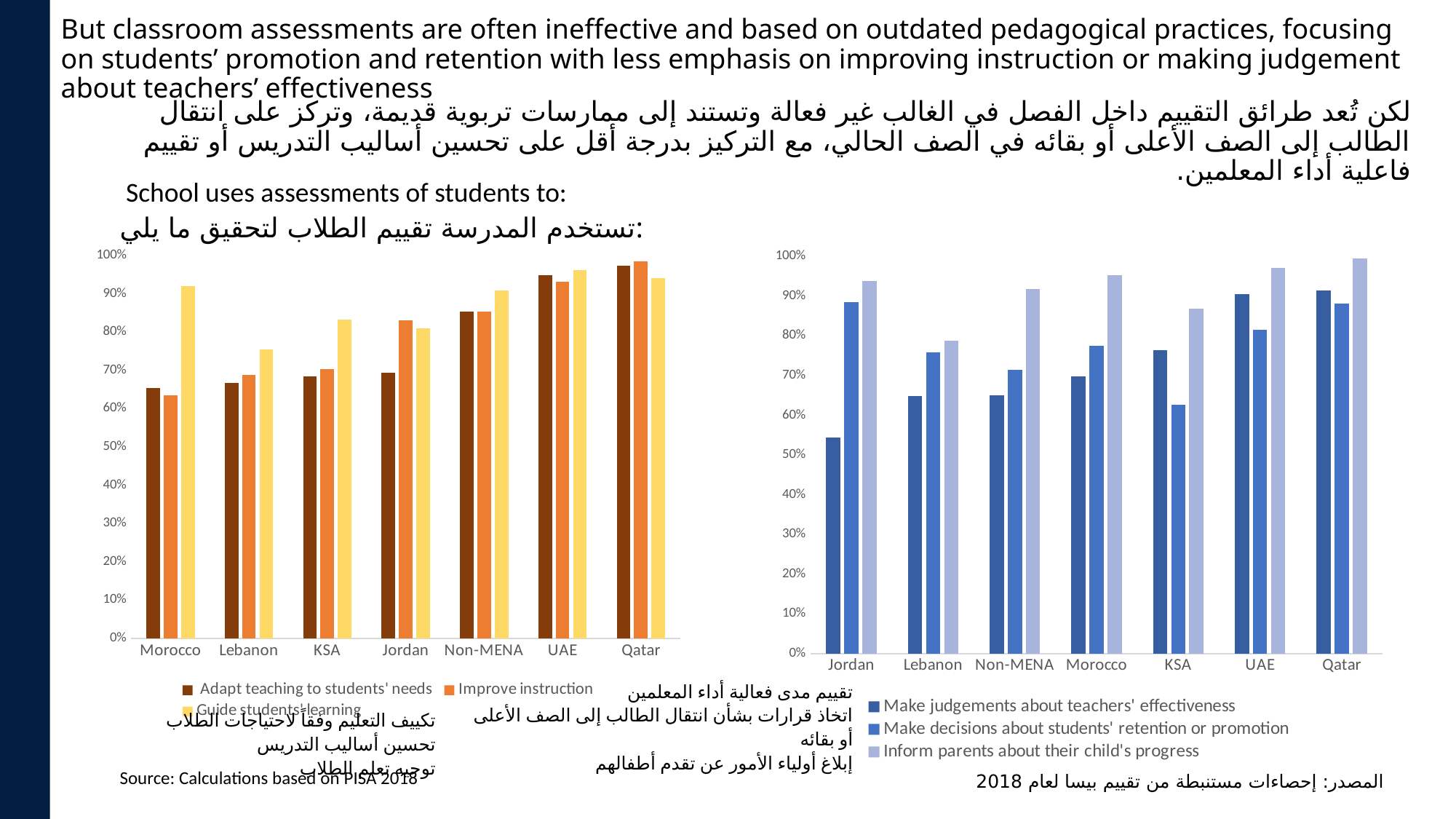
In the left chart, which category has the lowest value for 'Improve instruction'? Morocco In the right chart, for Morocco, which is larger: 'Make judgements about teachers' effectiveness' or 'Make decisions about students' retention or promotion'? Make decisions about students' retention or promotion In the left chart, which category has the lowest value for 'Guide students' learning'? Lebanon In the right chart, is the value for Lebanon for 'Inform parents about their child's progress' greater or less than 80%? less In the left chart, is the value for Morocco for 'Guide students' learning' greater or less than 90%? greater How many countries/regions are shown on the x axis of the right chart? 7 How many series does the legend of the right chart list? 3 In the right chart, is the value for Jordan for 'Make judgements about teachers' effectiveness' greater or less than 50%? greater In the right chart, which category has the lowest value for 'Make judgements about teachers' effectiveness'? Jordan In the right chart, which category has the highest value for 'Inform parents about their child's progress'? Qatar How many series does the legend of the left chart list? 3 What type of chart is the left chart on the slide? bar chart